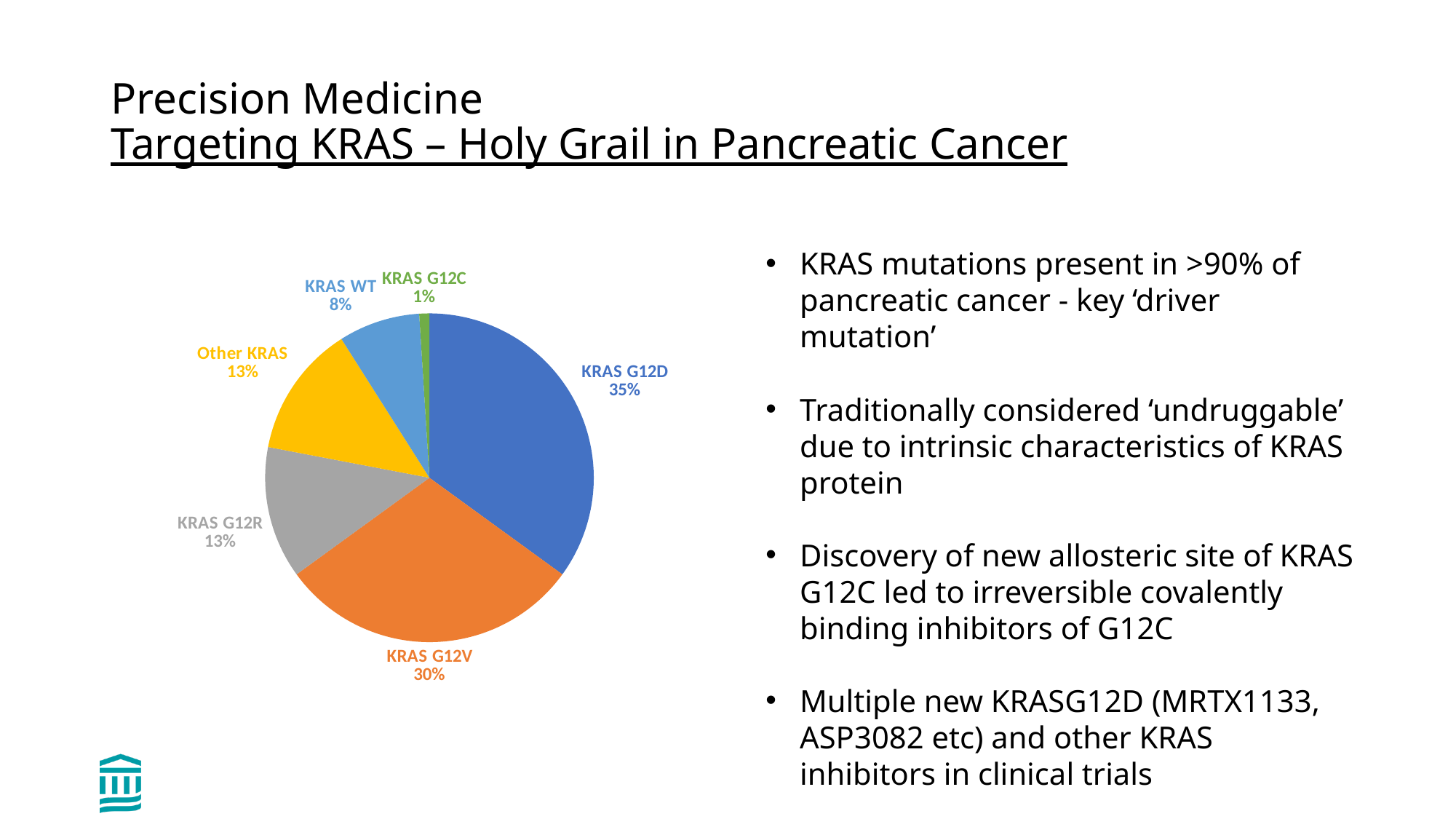
What share of the pie does KRAS G12D represent? 35% What kind of chart is shown on the slide? pie chart What is the value shown for KRAS G12C? 1% Which category has the smallest slice of the pie? KRAS G12C What is the value shown for KRAS WT? 8% What is the difference between the KRAS G12D and KRAS G12V shares? 5% What colour is the KRAS G12V slice? orange How many slices does the pie chart have? 6 What is the value shown for KRAS G12V? 30% What is the difference between the KRAS G12R and KRAS G12C shares? 12% Which category has the largest slice of the pie? KRAS G12D Which is larger, the share for KRAS WT or the share for Other KRAS? Other KRAS